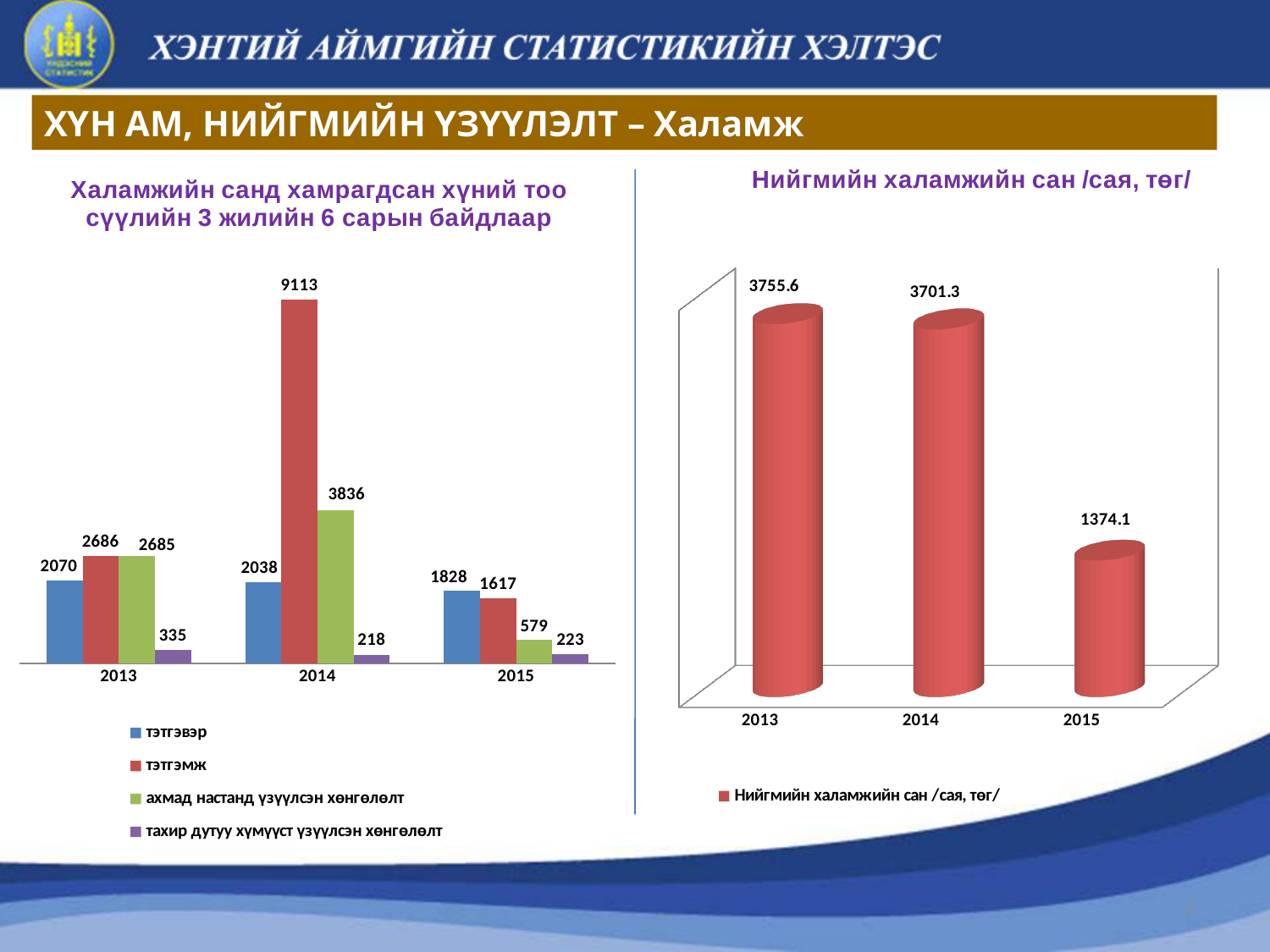
In the left chart (Халамжийн санд хамрагдсан хүний тоо), which year has the highest value for тэтгэмж? 2014 In the left chart (Халамжийн санд хамрагдсан хүний тоо), what is the difference between тэтгэмж and тэтгэвэр in 2014? 7075 What kind of chart is the right chart (Нийгмийн халамжийн сан /сая, төг/)? bar chart In the right chart (Нийгмийн халамжийн сан /сая, төг/), what is the difference between the 2014 and 2015 values? 2327.2 In the left chart (Халамжийн санд хамрагдсан хүний тоо), what is the value for тэтгэвэр in 2013? 2070 In the left chart (Халамжийн санд хамрагдсан хүний тоо), how many series does the legend list? 4 In the left chart (Халамжийн санд хамрагдсан хүний тоо), which year has the lowest value for тахир дутуу хүмүүст үзүүлсэн хөнгөлөлт? 2014 In the left chart (Халамжийн санд хамрагдсан хүний тоо), what is the value for ахмад настанд үзүүлсэн хөнгөлөлт in 2015? 579 In the left chart (Халамжийн санд хамрагдсан хүний тоо), does the value for тэтгэвэр rise or fall from 2013 to 2015? fall In the right chart (Нийгмийн халамжийн сан /сая, төг/), which year has the highest value? 2013 In the left chart (Халамжийн санд хамрагдсан хүний тоо), what is the value for тэтгэмж in 2014? 9113 In the right chart (Нийгмийн халамжийн сан /сая, төг/), what is the value for 2015? 1374.1